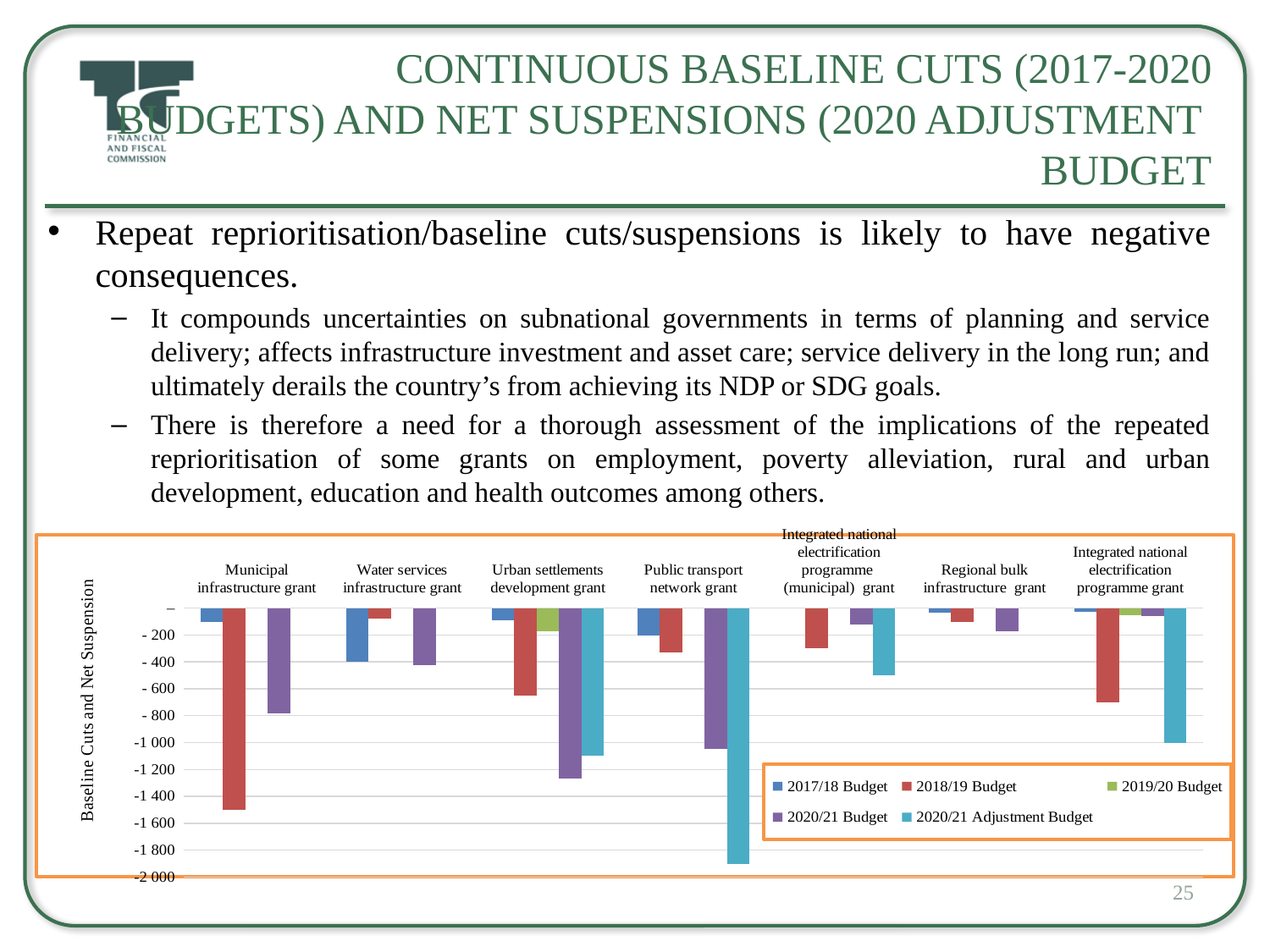
How many series does the chart's legend list? 5 Is the 2020/21 Adjustment Budget value for the Public transport network grant greater or less than -1 000? less What kind of chart is shown on the slide? bar chart Which grant has the largest (most negative) 2020/21 Adjustment Budget bar? Public transport network grant Is the 2018/19 Budget value for the Municipal infrastructure grant greater or less than -1 000? less What is the title of the vertical axis of the chart? Baseline Cuts and Net Suspension Which series in the legend is shown in red? 2018/19 Budget For the Municipal infrastructure grant, which is more negative: the 2018/19 Budget bar or the 2020/21 Budget bar? 2018/19 Budget Which grant has the largest (most negative) 2018/19 Budget bar? Municipal infrastructure grant How many grant categories are shown along the x axis of the chart? 7 For the Public transport network grant, which is more negative: the 2020/21 Budget bar or the 2020/21 Adjustment Budget bar? 2020/21 Adjustment Budget For the Public transport network grant, which series has the most negative value? 2020/21 Adjustment Budget